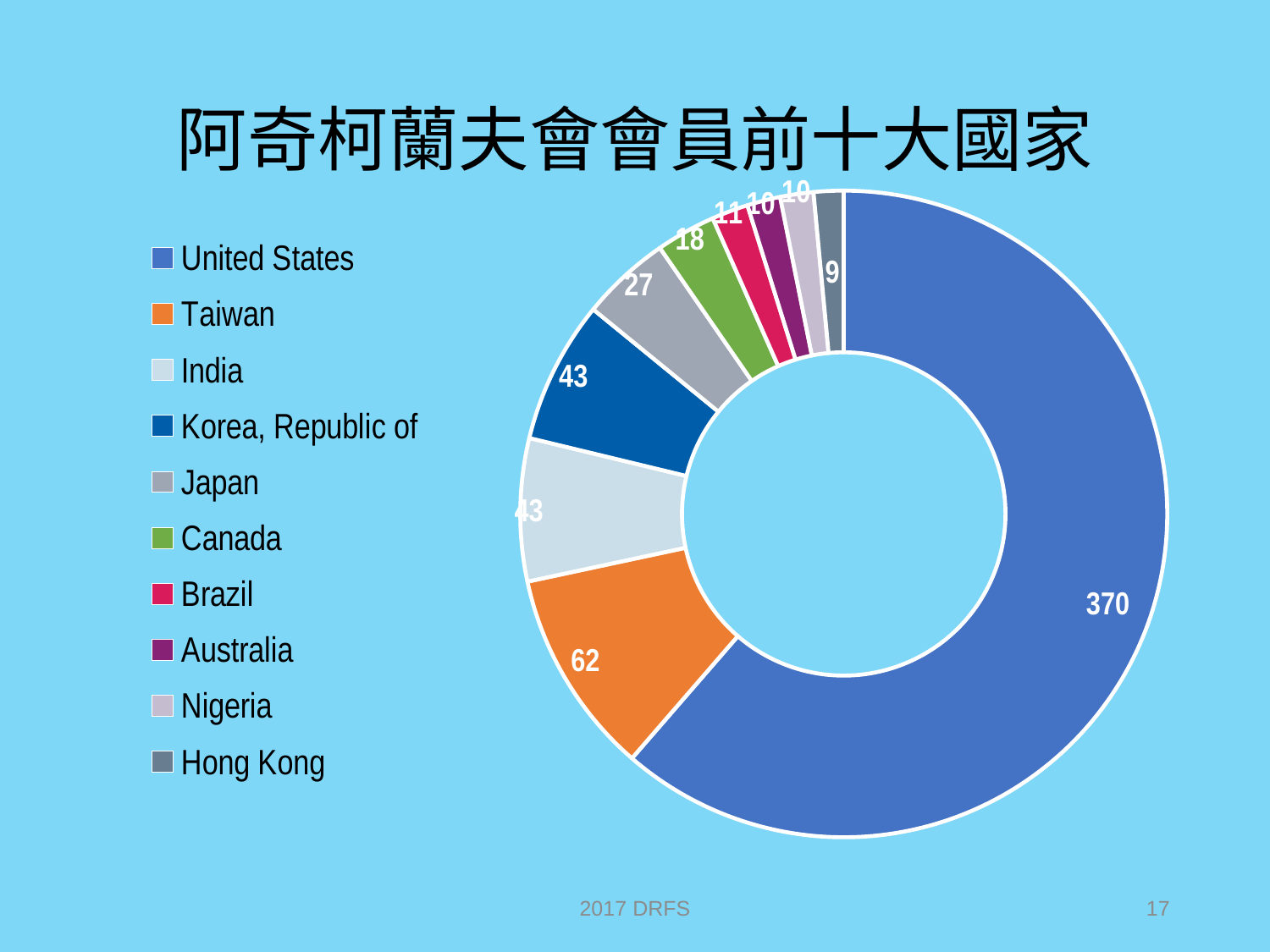
What is the value for Hong Kong? 9 Which is larger, the value for Taiwan or the value for Korea, Republic of? Taiwan What is the value for Canada? 18 What is the difference between the values for Taiwan and Japan? 35 How many countries are shown in the chart? 10 What kind of chart is shown on the slide? Doughnut (pie) chart What is the value for Japan? 27 What is the value for Taiwan? 62 What is the difference between the values for United States and Taiwan? 308 Which country has the highest value? United States Which country has the lowest value? Hong Kong What is the value for United States? 370